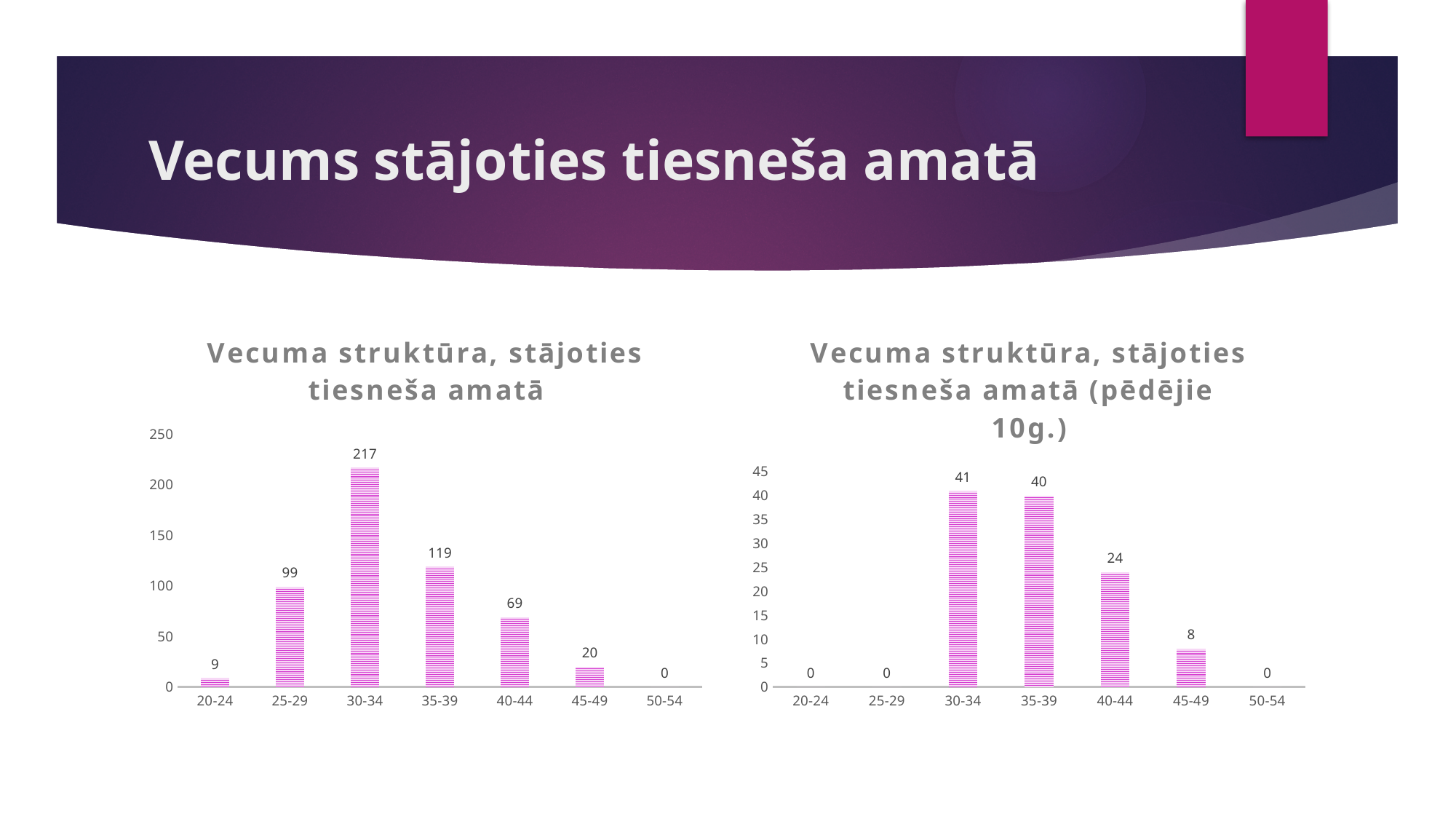
In the left chart 'Vecuma struktūra, stājoties tiesneša amatā', which age group has the highest value? 30-34 In the left chart 'Vecuma struktūra, stājoties tiesneša amatā', what is the difference between the values for 30-34 and 35-39? 98 In the left chart 'Vecuma struktūra, stājoties tiesneša amatā', what is the value for the 30-34 age group? 217 In the left chart 'Vecuma struktūra, stājoties tiesneša amatā', what is the value for the 45-49 age group? 20 In the right chart 'Vecuma struktūra, stājoties tiesneša amatā (pēdējie 10g.)', what is the value for the 40-44 age group? 24 In the right chart 'Vecuma struktūra, stājoties tiesneša amatā (pēdējie 10g.)', what is the difference between the values for 40-44 and 45-49? 16 How many age groups are shown on the x axis of the right chart 'Vecuma struktūra, stājoties tiesneša amatā (pēdējie 10g.)'? 7 In the right chart 'Vecuma struktūra, stājoties tiesneša amatā (pēdējie 10g.)', what is the value for the 25-29 age group? 0 What kind of chart is the left chart 'Vecuma struktūra, stājoties tiesneša amatā'? Bar chart In the right chart 'Vecuma struktūra, stājoties tiesneša amatā (pēdējie 10g.)', which age group has the highest value? 30-34 In the left chart 'Vecuma struktūra, stājoties tiesneša amatā', do the values rise or fall from 30-34 to 50-54? Fall In the left chart 'Vecuma struktūra, stājoties tiesneša amatā', which is larger, the value for 25-29 or the value for 40-44? 25-29